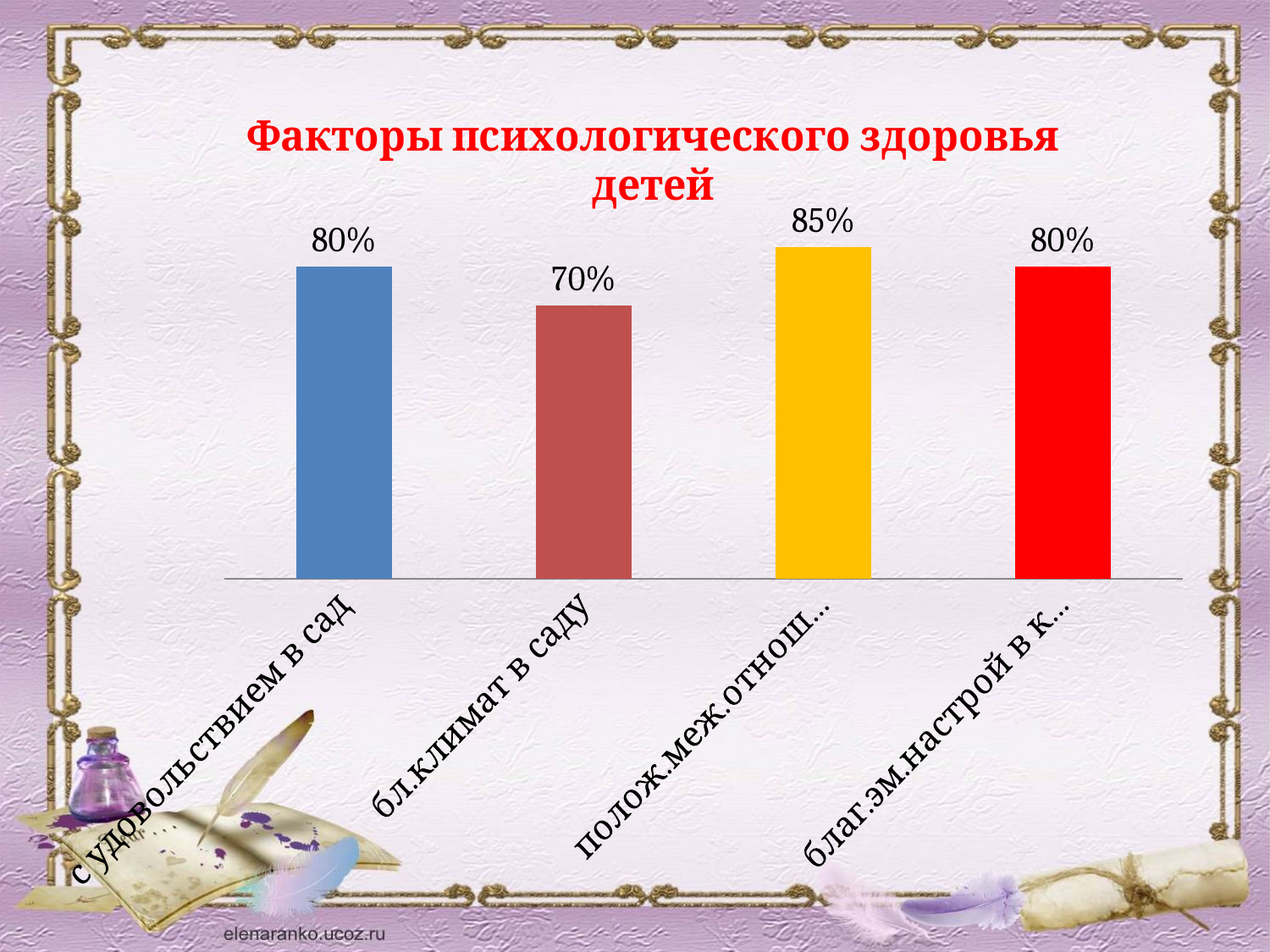
What is the difference between the values for "полож.меж.отнош..." and "бл.климат в саду"? 15% Which category has the lowest value? бл.климат в саду What is the difference between the values for "с удовольствием в сад" and "бл.климат в саду"? 10% Which is larger, the value for "полож.меж.отнош..." or the value for "с удовольствием в сад"? полож.меж.отнош... What kind of chart is shown on the slide? bar chart Which category has the highest value? полож.меж.отнош... What is the value for "бл.климат в саду"? 70% What is the value for the category labelled "полож.меж.отнош..."? 85% What is the title of the chart? Факторы психологического здоровья детей What is the value for "с удовольствием в сад"? 80% How many categories are shown in the chart? 4 What is the value for the category labelled "благ.эм.настрой в к..."? 80%